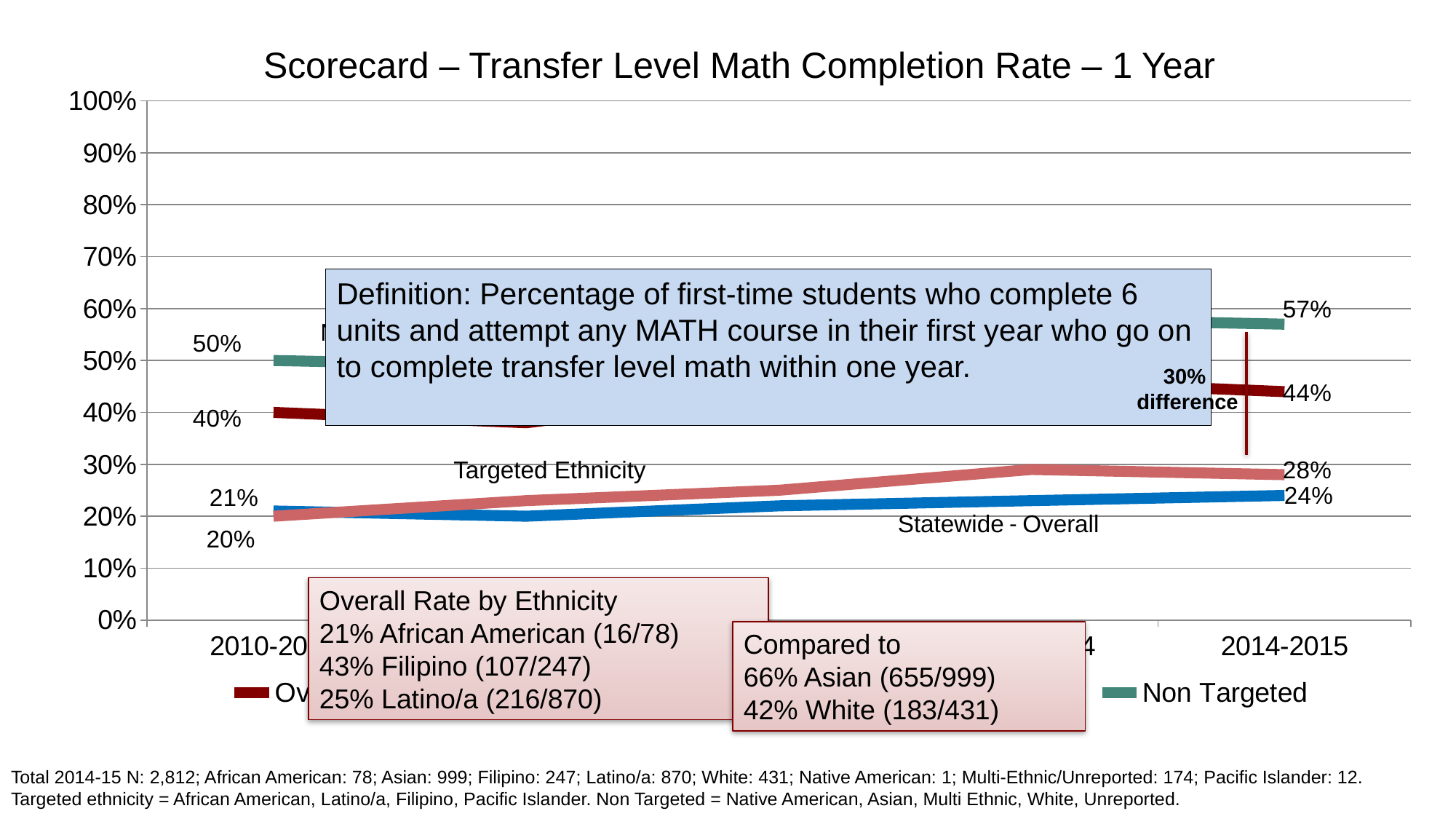
What is the difference between the Non Targeted and Overall rates in 2014-2015? 13% What is the Statewide - Overall completion rate in 2014-2015? 24% What is the title of the chart? Scorecard – Transfer Level Math Completion Rate – 1 Year What is the Overall completion rate in 2014-2015? 44% What is the Overall completion rate in 2010-2011? 40% Does the Non Targeted rate rise or fall from 2010-2011 to 2014-2015? rise What is the Non Targeted completion rate in 2014-2015? 57% Which series has the highest value in 2014-2015? Non Targeted Which series has the lowest value in 2014-2015? Statewide - Overall What is the Targeted Ethnicity completion rate in 2014-2015? 28% What is the Non Targeted completion rate in 2010-2011? 50% What kind of chart is shown on the slide? line chart